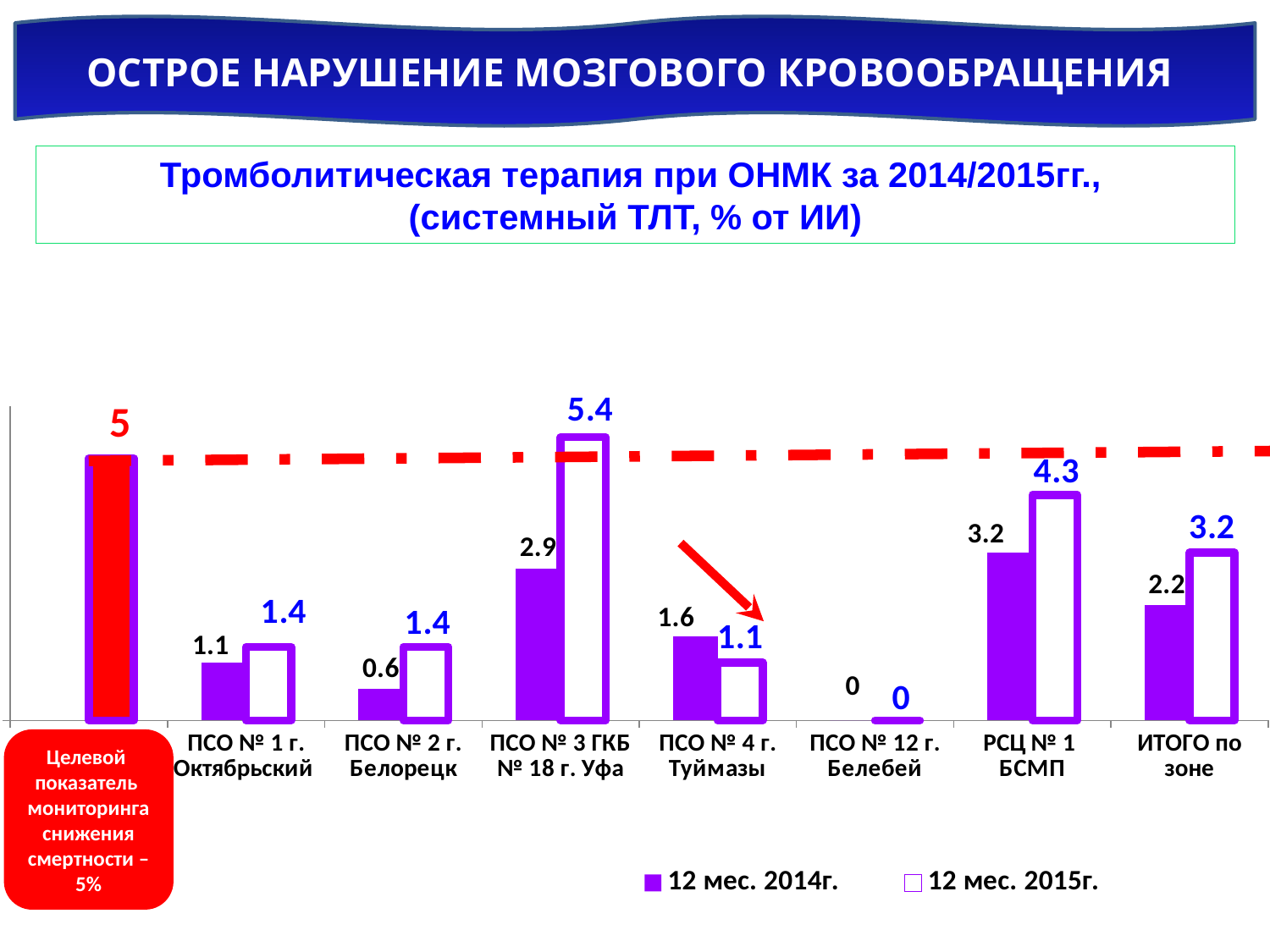
На сколько значение ПСО № 3 ГКБ № 18 г. Уфа за 12 мес. 2015г. больше, чем за 12 мес. 2014г.? 2.5 Какое значение показано для РСЦ № 1 БСМП за 12 мес. 2014г.? 3.2 Что больше для ПСО № 4 г. Туймазы: значение за 12 мес. 2014г. или за 12 мес. 2015г.? 12 мес. 2014г. Сколько серий указано в легенде диаграммы? 2 Какого типа эта диаграмма? Столбчатая (bar chart) Какое значение показано для ИТОГО по зоне за 12 мес. 2015г.? 3.2 Какое значение показано для ПСО № 2 г. Белорецк за 12 мес. 2014г.? 0.6 У какого учреждения самое низкое значение за 12 мес. 2014г.? ПСО № 12 г. Белебей Какое значение показано для ПСО № 12 г. Белебей за 12 мес. 2015г.? 0 Какой целевой показатель мониторинга снижения смертности указан на диаграмме? 5% Какое значение показано для ПСО № 3 ГКБ № 18 г. Уфа за 12 мес. 2015г.? 5.4 У какого учреждения самое высокое значение за 12 мес. 2015г.? ПСО № 3 ГКБ № 18 г. Уфа